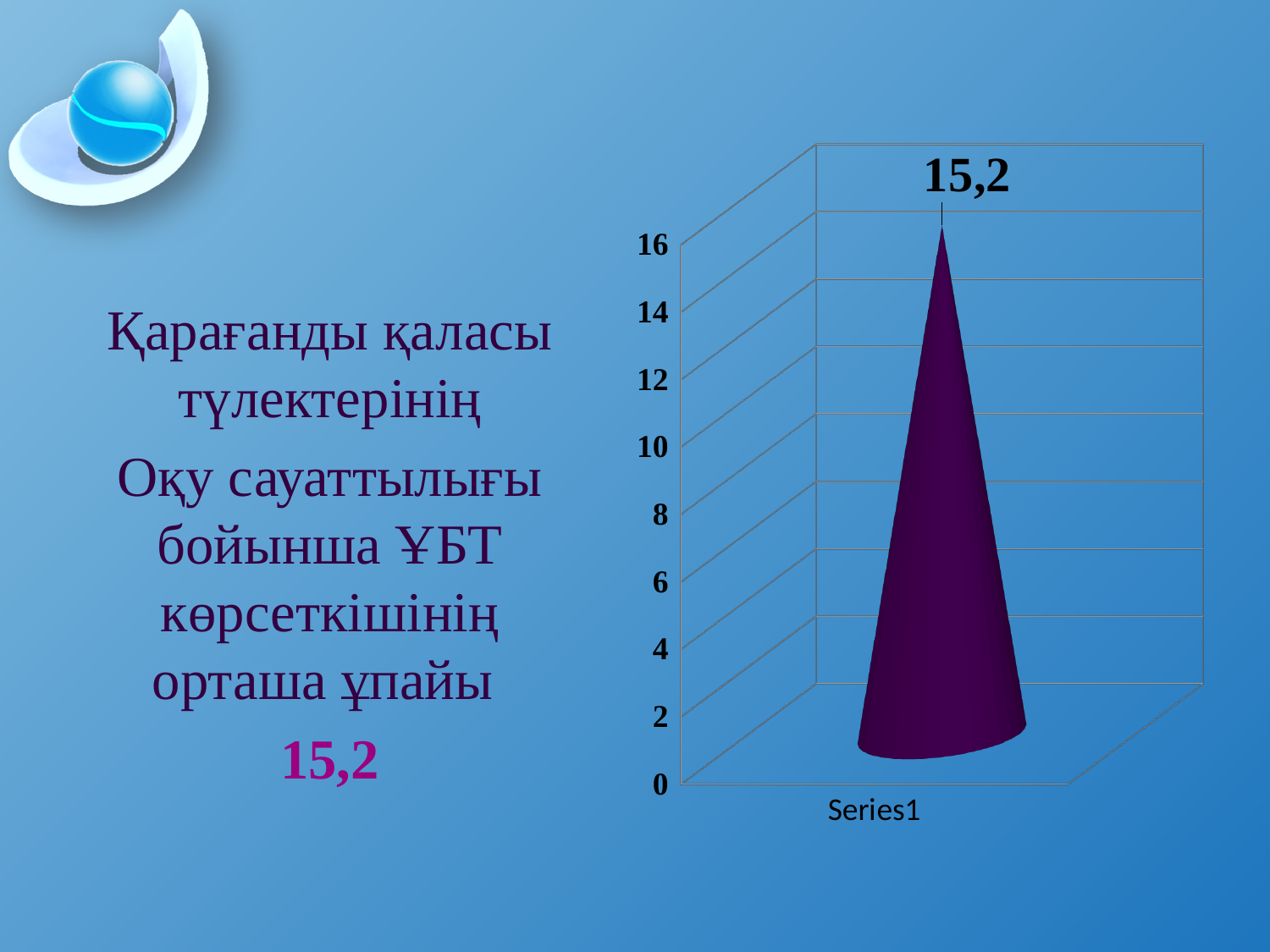
What is the category label shown under the bar on the horizontal axis? Series1 What kind of chart is shown on the slide? bar chart What value is shown by the data label on the bar in the chart? 15,2 What is the highest tick value shown on the vertical axis of the chart? 16 How many bars are plotted in the chart? 1 What is the value for Series1 in the chart? 15,2 Is the value for Series1 greater or less than 14? greater Is the value for Series1 greater or less than 16? less